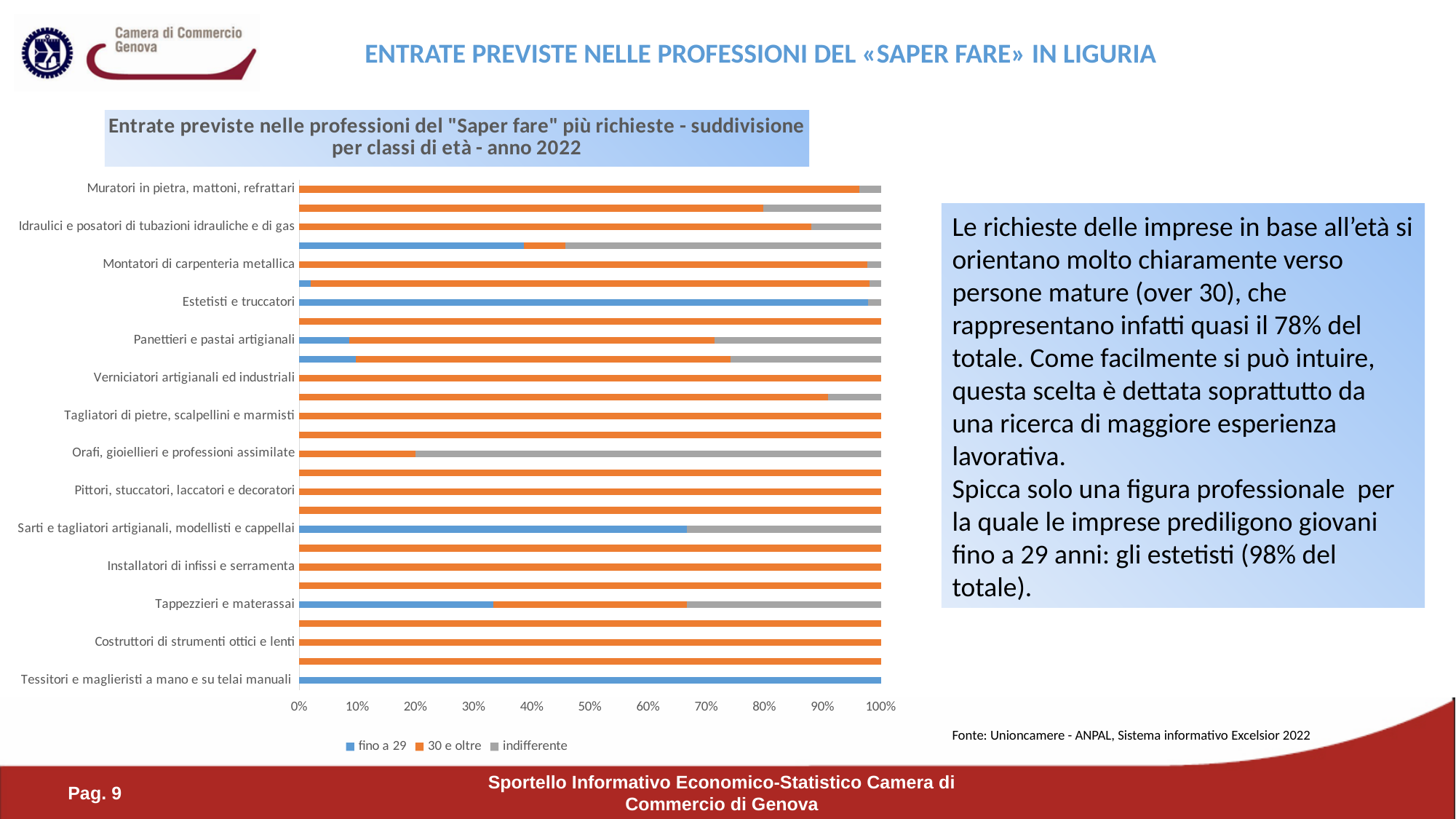
What are the three series listed in the chart legend? fino a 29, 30 e oltre, indifferente Which colour represents the series "30 e oltre" in the chart? Orange For "Orafi, gioiellieri e professioni assimilate", which is larger: the "30 e oltre" share or the "indifferente" share? indifferente Is the value of "fino a 29" for "Tappezzieri e materassai" greater or less than 40%? less What kind of chart is shown on the slide? Stacked bar chart How many series does the chart legend list? 3 Is the value of "fino a 29" for "Estetisti e truccatori" greater or less than 90%? greater Is the value of "fino a 29" for "Sarti e tagliatori artigianali, modellisti e cappellai" greater or less than 60%? greater For "Sarti e tagliatori artigianali, modellisti e cappellai", which is larger: the "fino a 29" share or the "indifferente" share? fino a 29 What is the value of "fino a 29" for "Tessitori e maglieristi a mano e su telai manuali"? 100% What is the value of "30 e oltre" for "Costruttori di strumenti ottici e lenti"? 100%